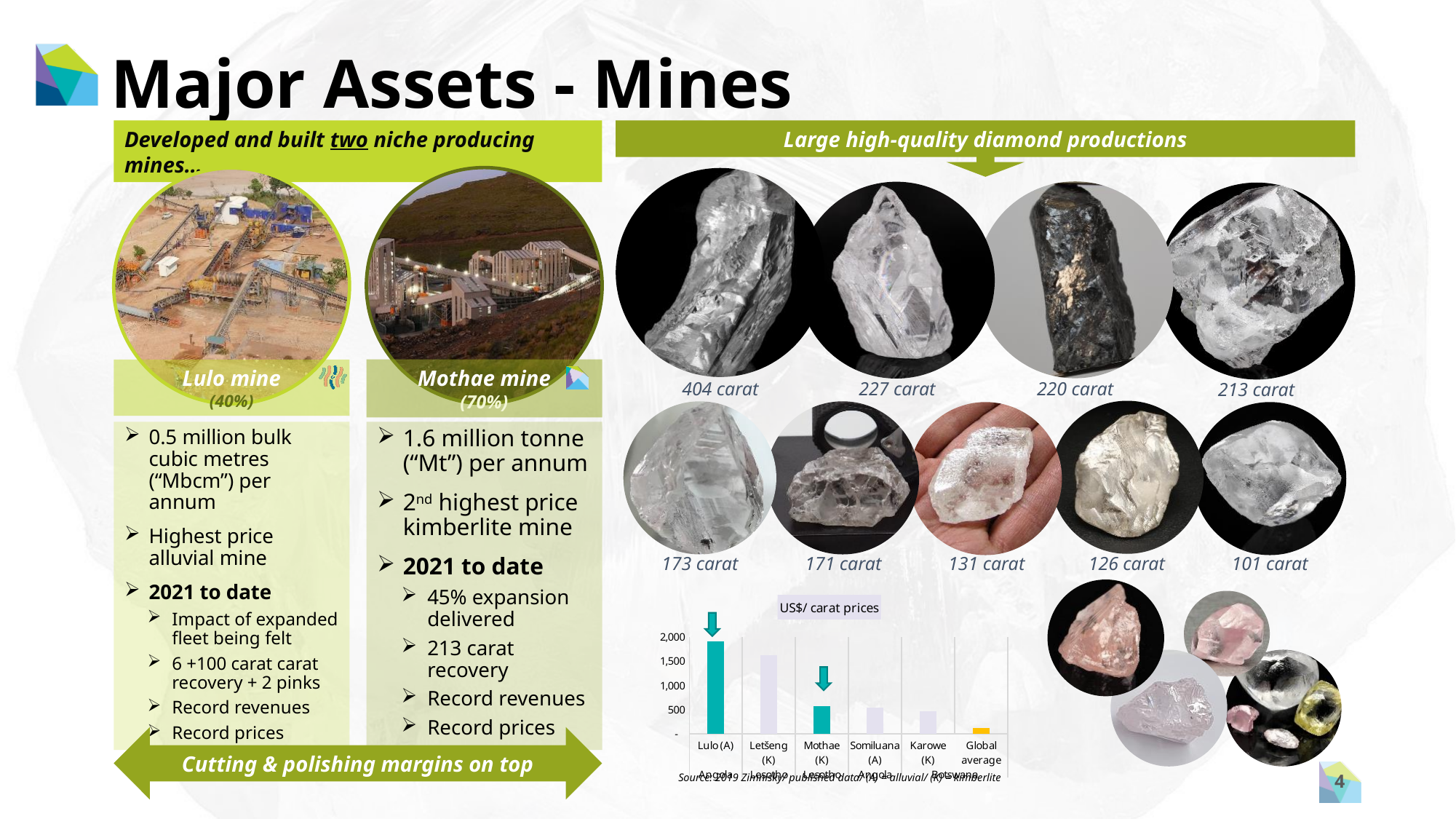
Is the US$/ carat price for Mothae (K) greater or less than 1,000? less Is the US$/ carat price for Letšeng (K) greater or less than 1,000? greater What kind of chart is the US$/ carat prices chart? bar chart Which category has the lowest US$/ carat price in the chart? Global average Is the US$/ carat price for Lulo (A) greater or less than 1,500? greater Which category has the highest US$/ carat price in the chart? Lulo (A) Do the US$/ carat prices rise or fall moving from left to right across the chart? fall Which has a higher US$/ carat price, Lulo (A) or Mothae (K)? Lulo (A) What is the title of the bar chart on the slide? US$/ carat prices How many mines/categories are shown on the x axis of the US$/ carat prices chart? 6